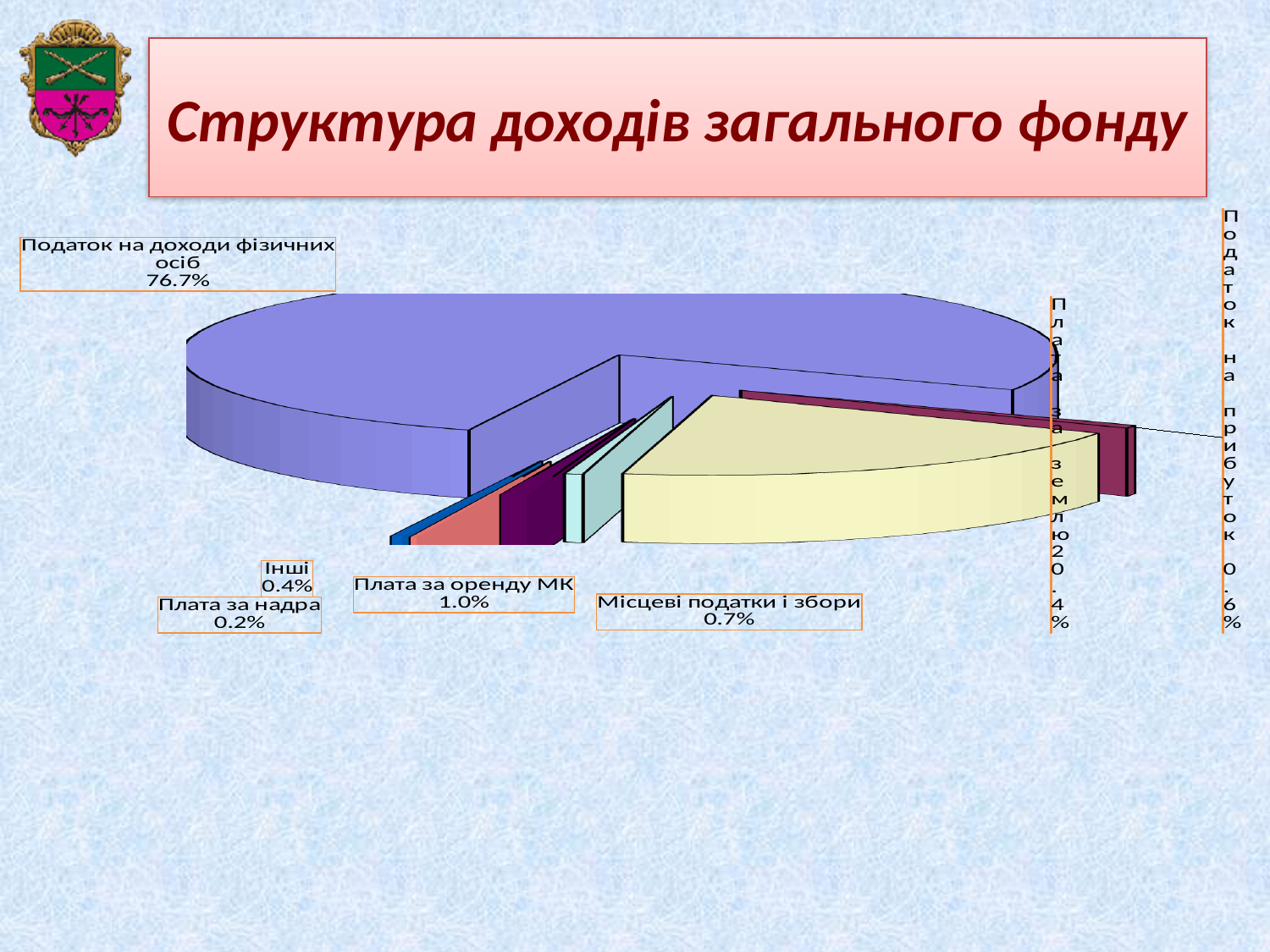
Which is larger, the share for Інші or the share for Плата за надра? Інші What is the difference between the shares of Податок на доходи фізичних осіб and Плата за землю? 56.3% How many slices does the pie chart have? 7 What is the value shown for Плата за землю? 20.4% Which category has the smallest share of the pie? Плата за надра Which category has the largest share of the pie? Податок на доходи фізичних осіб What is the value shown for Плата за оренду МК? 1.0% What is the value shown for Податок на прибуток? 0.6% What is the value shown for Місцеві податки і збори? 0.7% What is the title of the slide? Структура доходів загального фонду What type of chart is shown on the slide? Pie chart What share of the pie does Податок на доходи фізичних осіб have? 76.7%